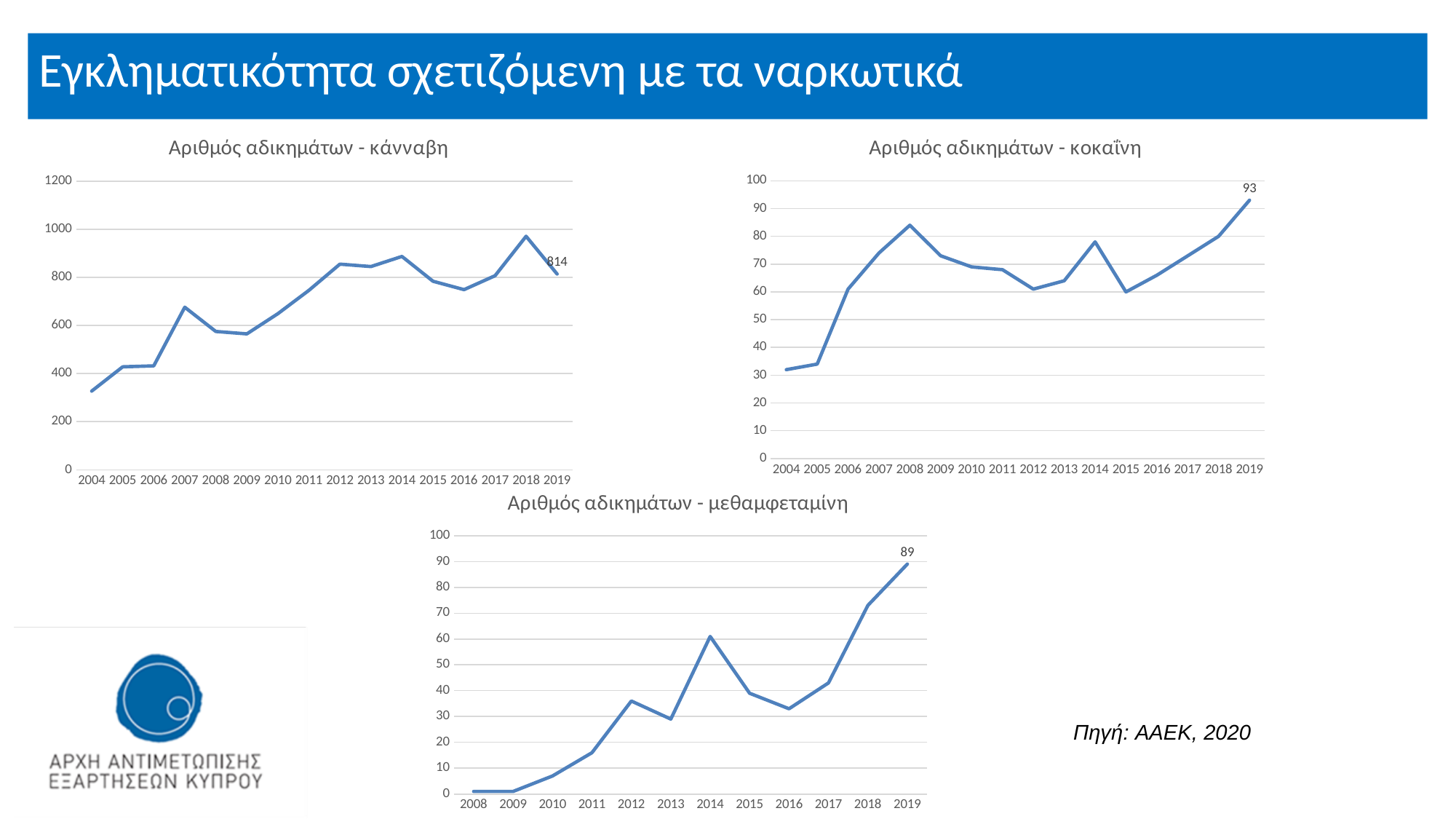
In the chart titled 'Αριθμός αδικημάτων - κοκαΐνη', is the value for 2004 greater or less than 40? less In the chart titled 'Αριθμός αδικημάτων - μεθαμφεταμίνη', is the value for 2014 greater or less than 50? greater In the chart titled 'Αριθμός αδικημάτων - κάνναβη', what is the value for 2019? 814 In the chart titled 'Αριθμός αδικημάτων - μεθαμφεταμίνη', which year has the highest value? 2019 In the chart titled 'Αριθμός αδικημάτων - κοκαΐνη', which year has the highest value? 2019 In the chart titled 'Αριθμός αδικημάτων - κάνναβη', is the value for 2007 greater or less than 600? greater How many years are shown on the x axis of the chart titled 'Αριθμός αδικημάτων - μεθαμφεταμίνη'? 12 In the chart titled 'Αριθμός αδικημάτων - μεθαμφεταμίνη', what is the value for 2019? 89 In the chart titled 'Αριθμός αδικημάτων - κοκαΐνη', what is the value for 2019? 93 In the chart titled 'Αριθμός αδικημάτων - κάνναβη', which year has the highest value? 2018 What kind of chart is the chart titled 'Αριθμός αδικημάτων - κοκαΐνη'? line chart In the chart titled 'Αριθμός αδικημάτων - κάνναβη', which year has the lowest value? 2004